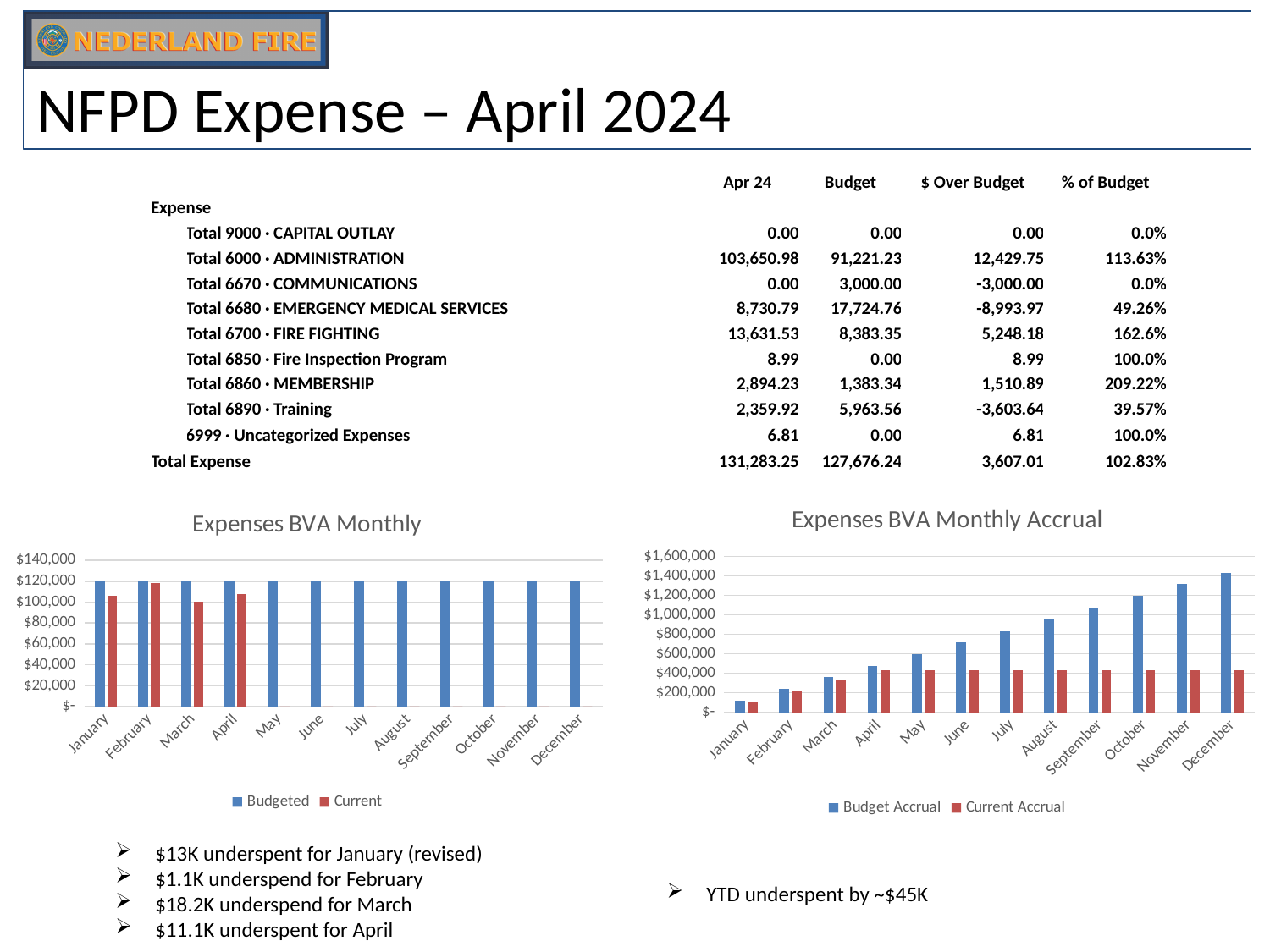
In the "Expenses BVA Monthly" chart, which is larger for January, Budgeted or Current? Budgeted How many series does the legend of the "Expenses BVA Monthly" chart list? 2 In the "Expenses BVA Monthly Accrual" chart, which month has the highest Budget Accrual value? December In the "Expenses BVA Monthly" chart, is the Current value for March greater or less than $120,000? less What are the two legend entries of the "Expenses BVA Monthly Accrual" chart? Budget Accrual and Current Accrual In the "Expenses BVA Monthly Accrual" chart, is the Budget Accrual value for December greater or less than $1,200,000? greater What kind of chart is the "Expenses BVA Monthly" chart on the left? Bar chart In the "Expenses BVA Monthly Accrual" chart, which month has the lowest Budget Accrual value? January In the "Expenses BVA Monthly" chart, is the Budgeted value for January greater or less than $100,000? greater In the "Expenses BVA Monthly Accrual" chart, do the Budget Accrual values rise or fall from January to December? Rise In the "Expenses BVA Monthly Accrual" chart, which is larger for December, Budget Accrual or Current Accrual? Budget Accrual How many months are shown on the x axis of the "Expenses BVA Monthly" chart? 12